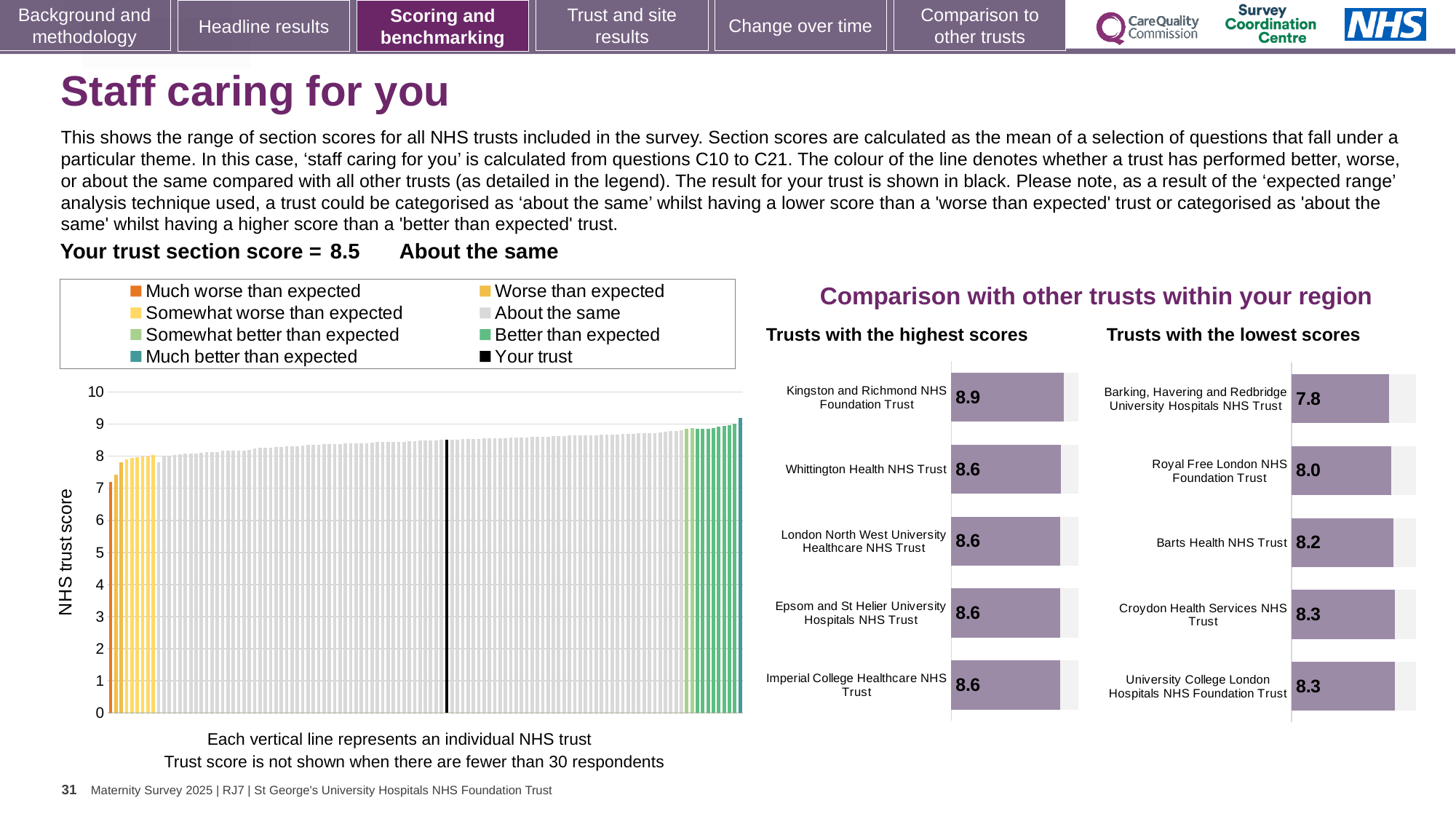
In the 'Trusts with the lowest scores' chart, what is the difference between the scores of Barts Health NHS Trust and Barking, Havering and Redbridge University Hospitals NHS Trust? 0.4 What kind of chart is the main 'NHS trust score' chart on the left? Bar chart In the 'Trusts with the highest scores' chart, which trust has the highest score? Kingston and Richmond NHS Foundation Trust In the 'Trusts with the highest scores' chart, what is the difference between the scores of Kingston and Richmond NHS Foundation Trust and Whittington Health NHS Trust? 0.3 In the 'Trusts with the lowest scores' chart, what is the score for Barts Health NHS Trust? 8.2 In the 'Trusts with the lowest scores' chart, which has the higher score: Royal Free London NHS Foundation Trust or Croydon Health Services NHS Trust? Croydon Health Services NHS Trust In the main 'NHS trust score' chart, do the trust scores rise or fall from left to right? Rise In the 'Trusts with the lowest scores' chart, what is the score for Barking, Havering and Redbridge University Hospitals NHS Trust? 7.8 How many trusts are shown in the 'Trusts with the highest scores' chart? 5 In the 'Trusts with the lowest scores' chart, which trust has the lowest score? Barking, Havering and Redbridge University Hospitals NHS Trust In the 'Trusts with the highest scores' chart, what is the score for Kingston and Richmond NHS Foundation Trust? 8.9 How many entries does the legend of the main 'NHS trust score' chart list? 8